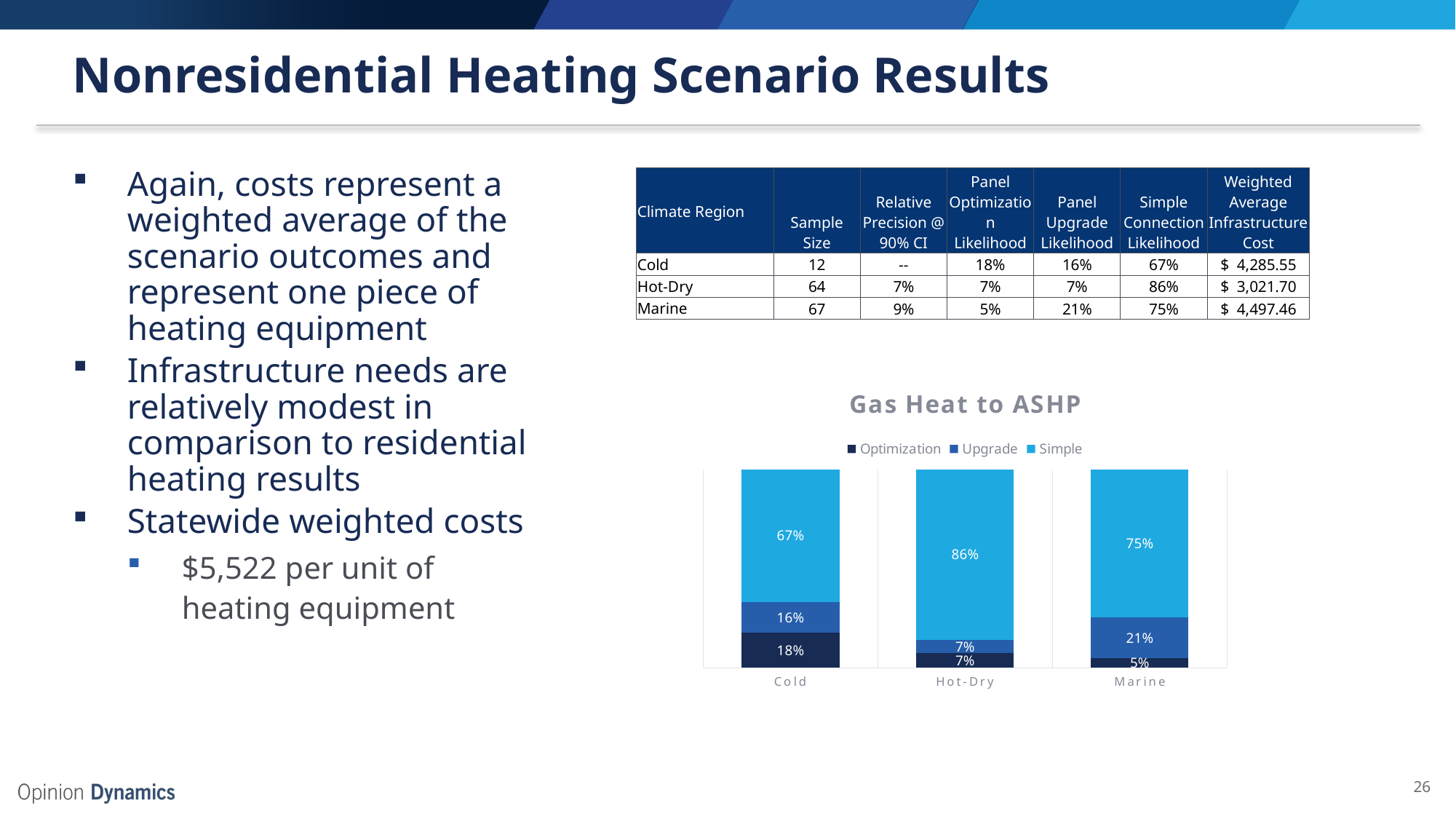
What is the Upgrade value for Marine in the chart? 21% What is the difference between the Simple values for Marine and Cold in the chart? 8% Which climate region has the highest Simple value in the chart? Hot-Dry What kind of chart is shown on the slide? Stacked bar chart What is the Simple value for Hot-Dry in the chart? 86% What is the Optimization value for Cold in the chart? 18% How many series does the chart legend list? 3 What is the title of the chart? Gas Heat to ASHP Which climate region has the lowest Optimization value in the chart? Marine What is the total of the stacked bar for Marine in the chart? 101% Which is larger in the chart: the Upgrade value for Cold or the Upgrade value for Hot-Dry? Cold How many climate regions are shown on the x axis of the chart? 3